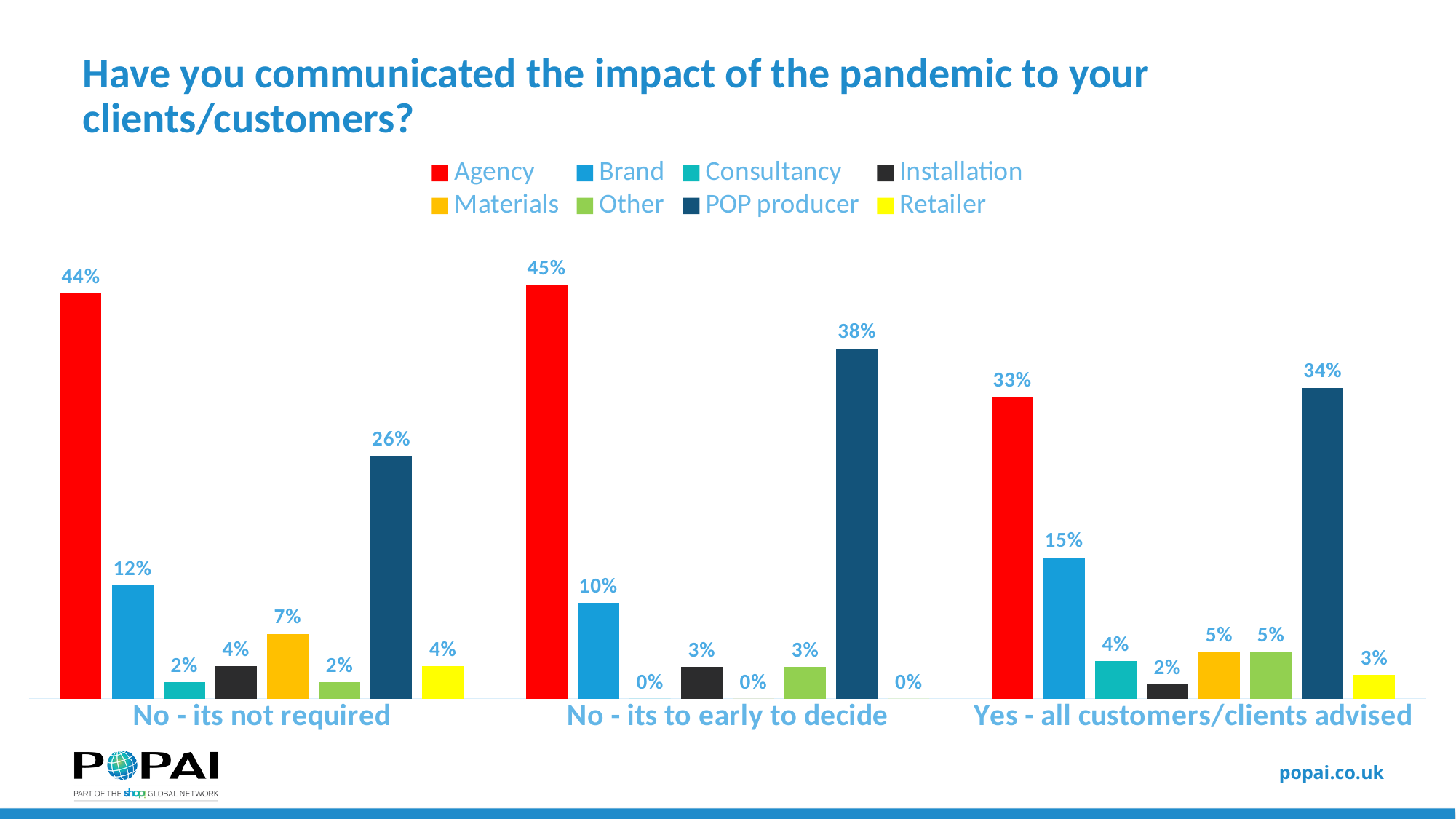
What is the value for Materials in the 'No - its to early to decide' category? 0% Is the Agency value larger in 'No - its not required' or in 'Yes - all customers/clients advised'? No - its not required Which series has the highest value in the 'No - its to early to decide' category? Agency What is the difference between the Agency and POP producer values in the 'No - its not required' category? 18% What is the value for POP producer in the 'No - its to early to decide' category? 38% What colour represents the Retailer series in the legend? Yellow What is the value for Agency in the 'No - its not required' category? 44% Which series has the highest value in the 'Yes - all customers/clients advised' category? POP producer How many categories are shown on the x axis? 3 How many series does the legend list? 8 What type of chart is shown on the slide? Bar chart What is the value for Brand in the 'Yes - all customers/clients advised' category? 15%